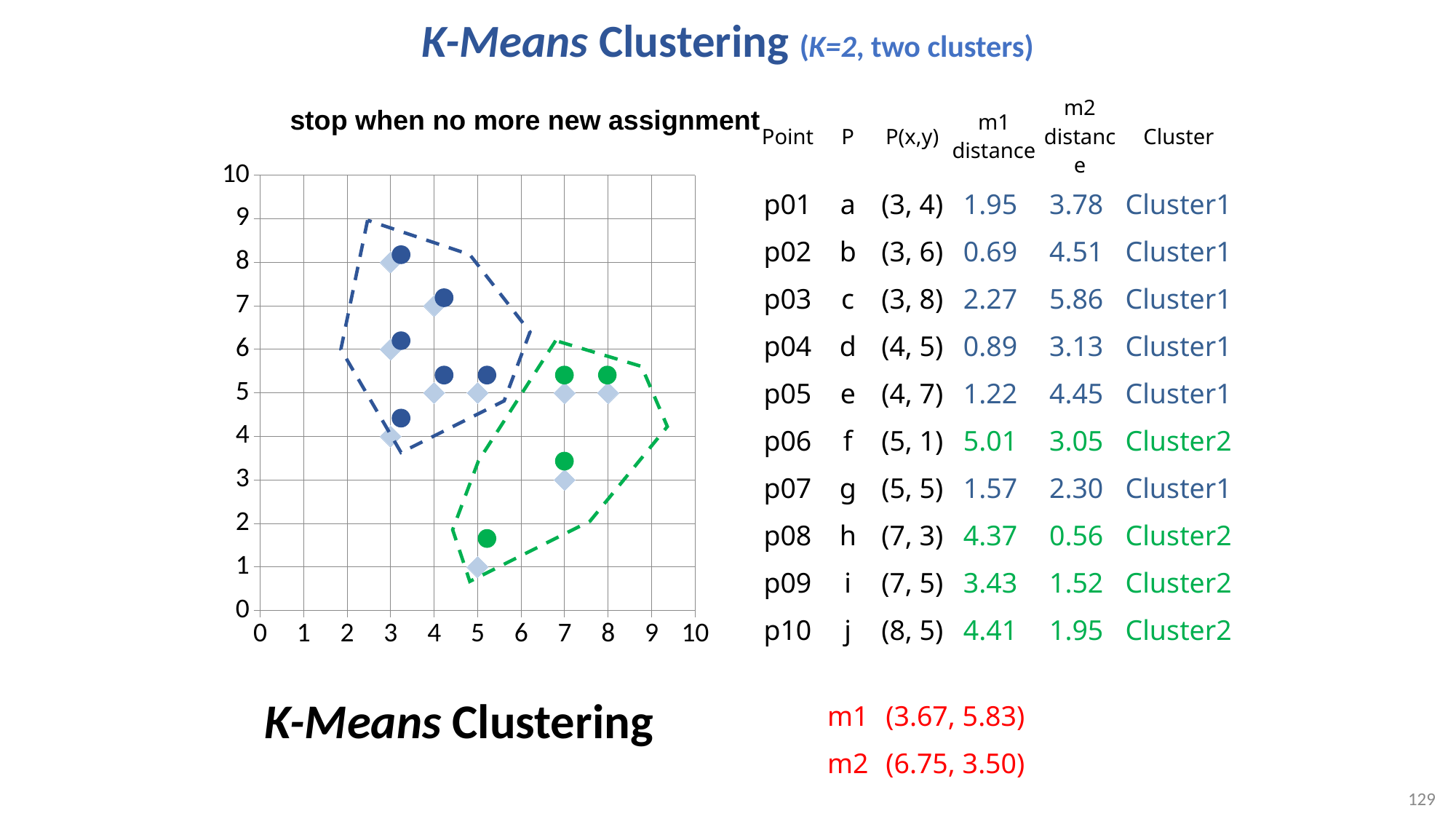
What is the maximum value shown on the chart's x axis? 10 Which has the larger x value: the rightmost point in the green dashed outline or the leftmost point in the blue dashed outline? the rightmost point in the green outline How many light-blue diamond data points are plotted on the chart? 10 What is the title printed above the chart? stop when no more new assignment How many blue circle markers are drawn on the chart? 6 What are the coordinates of the plotted point with the lowest y value? (5, 1) How many plotted points lie on the horizontal grid line y = 5? 4 What is the difference in x between the two points inside the green dashed outline that lie at y = 5? 1 What are the coordinates of the plotted point with the highest y value? (3, 8) Is the y value of the lowest point inside the green dashed outline greater or less than 2? less What kind of chart is shown on the left of the slide? scatter chart